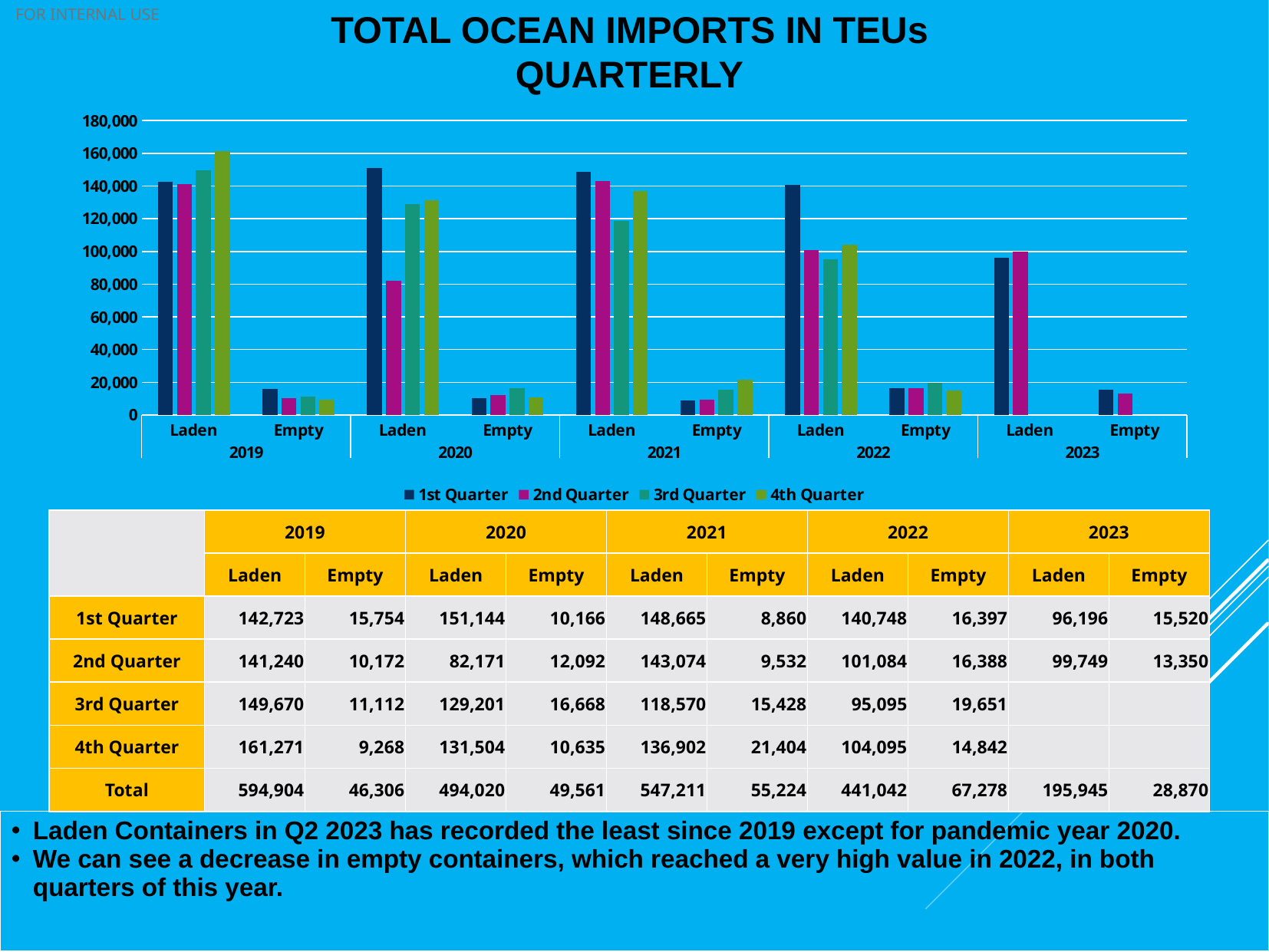
In 2021, which is larger: the 1st Quarter Laden value or the 2nd Quarter Laden value? 1st Quarter Does the 1st Quarter Laden value rise or fall from 2020 to 2023? fall Is the 1st Quarter Laden value for 2022 greater or less than 120,000? greater Which quarter has the highest Laden value in 2019? 4th Quarter How many years are shown along the x axis of the chart? 5 What is the 4th Quarter Empty value for 2021? 21,404 What kind of chart is shown on the slide? bar chart What is the total Laden value for 2022? 441,042 How many series does the chart legend list? 4 What is the difference between the 4th Quarter and 1st Quarter Laden values in 2019? 18,548 Which quarter has the lowest Laden value in 2020? 2nd Quarter What is the 1st Quarter Laden value for 2019? 142,723